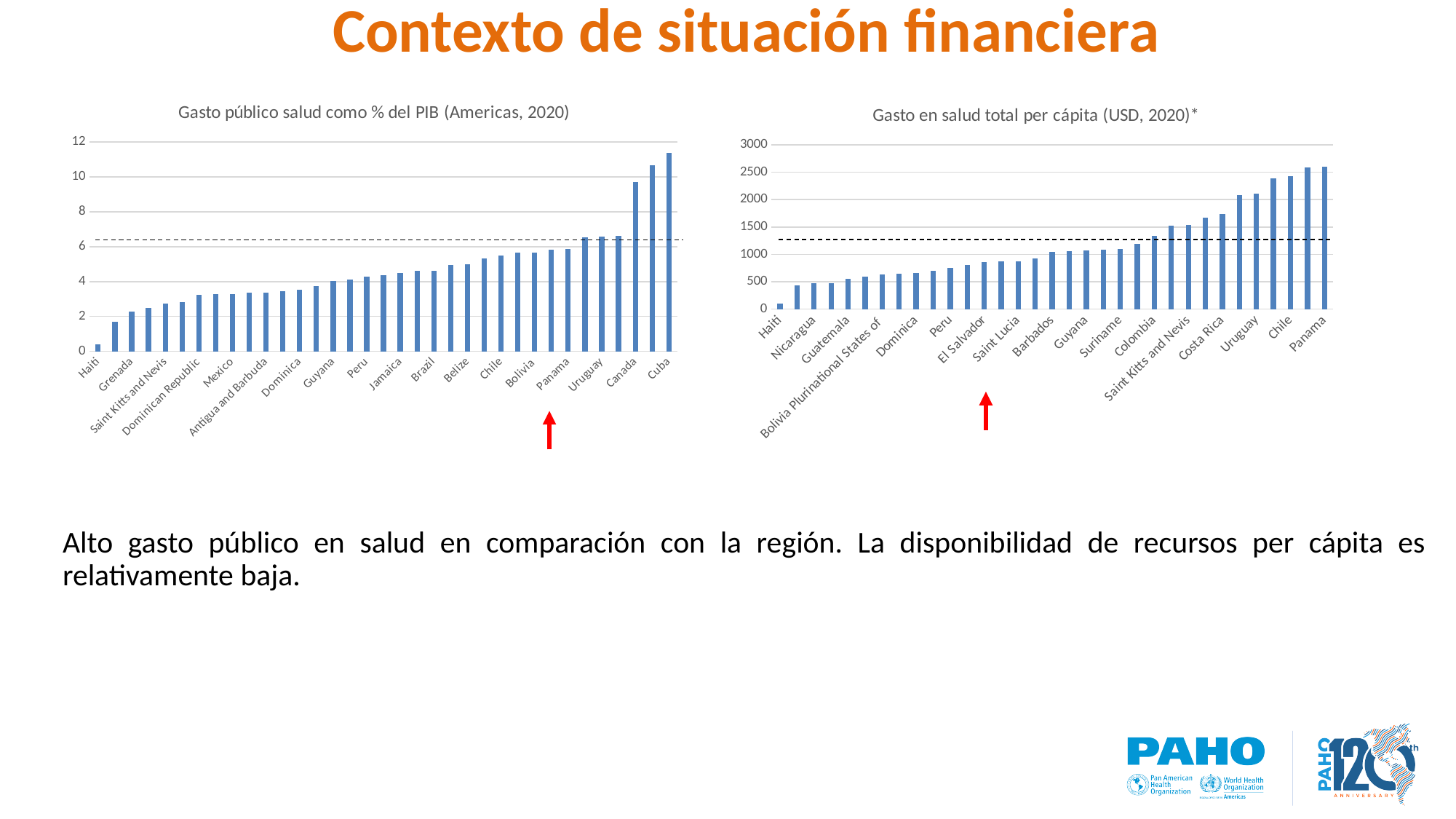
In the left chart 'Gasto público salud como % del PIB', which country has the lowest value? Haiti In the left chart 'Gasto público salud como % del PIB', is the value for Mexico greater or less than 4? less In the left chart 'Gasto público salud como % del PIB', do the values rise or fall from left to right along the x axis? rise What kind of chart is the left chart, 'Gasto público salud como % del PIB (Americas, 2020)'? bar chart In the right chart 'Gasto en salud total per cápita (USD, 2020)', which country has the lowest value? Haiti In the left chart 'Gasto público salud como % del PIB', is the value for Cuba greater or less than 10? greater In the left chart 'Gasto público salud como % del PIB', is the value for Canada greater or less than 8? greater In the left chart 'Gasto público salud como % del PIB', which country has the highest value? Cuba In the right chart 'Gasto en salud total per cápita (USD, 2020)', which is larger, the value for Panama or the value for Nicaragua? Panama In the left chart 'Gasto público salud como % del PIB', which is larger, the value for Canada or the value for Uruguay? Canada